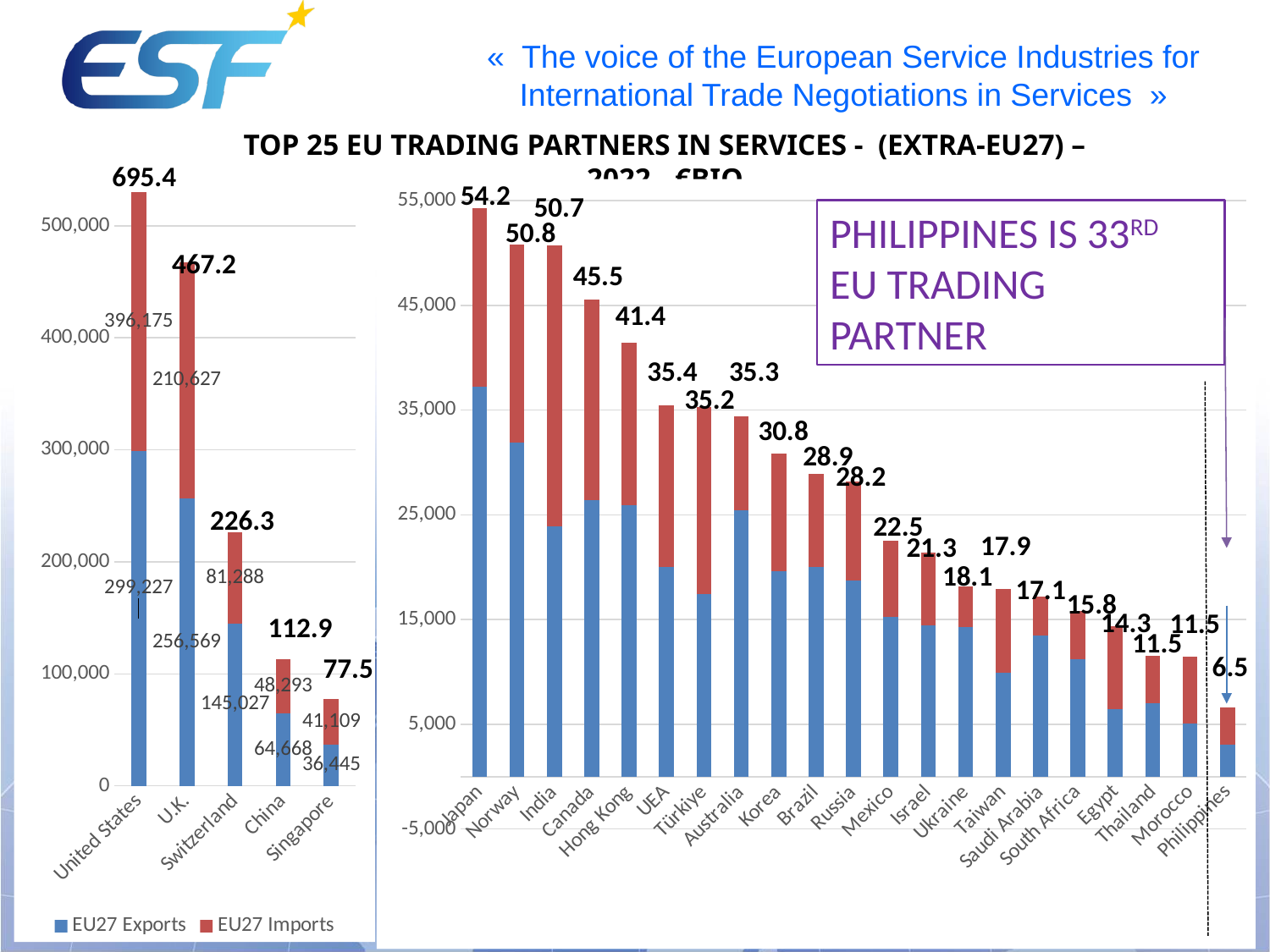
What kind of chart is the right chart? Stacked bar chart In the right chart, which country has the highest value? Japan How many series does the legend of the left chart list? 2 In the right chart, what is the value labelled for Philippines? 6.5 In the left chart, which country has the highest total? United States In the left chart, what is the total value labelled for United States? 695.4 How many countries are shown in the right chart? 21 In the left chart, what is the difference between the totals labelled for U.K. and Switzerland? 240.9 In the left chart, which country has the lowest total? Singapore In the right chart, do the values rise or fall from Japan to Philippines? Fall In the right chart, what is the value labelled for Japan? 54.2 In the right chart, which is larger, the value for Canada or the value for Hong Kong? Canada